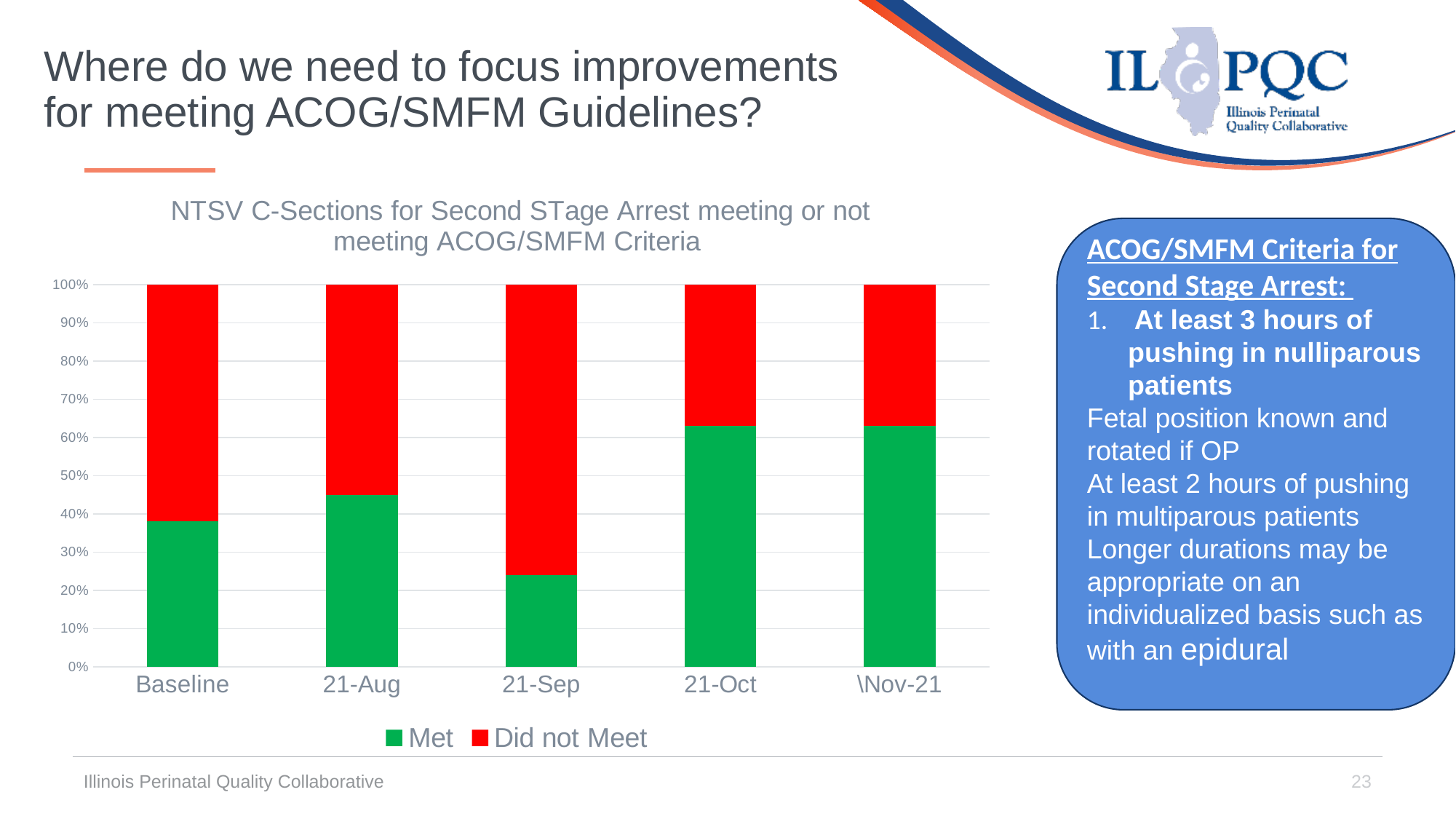
Which category has the lowest 'Met' share? 21-Sep Which category has the largest 'Did not Meet' share? 21-Sep What is the total of the stacked bar for Baseline? 100% Which has the larger 'Met' share, Baseline or 21-Aug? 21-Aug What kind of chart is shown on the slide? Stacked bar chart Is the 'Met' share for 21-Aug greater or less than 50%? less Is the 'Met' share for Baseline greater or less than 50%? less How many categories are shown on the x axis of the chart? 5 Is the 'Met' share for 21-Oct greater or less than 60%? greater Which colour represents the 'Did not Meet' series in the chart? Red How many series does the chart legend list? 2